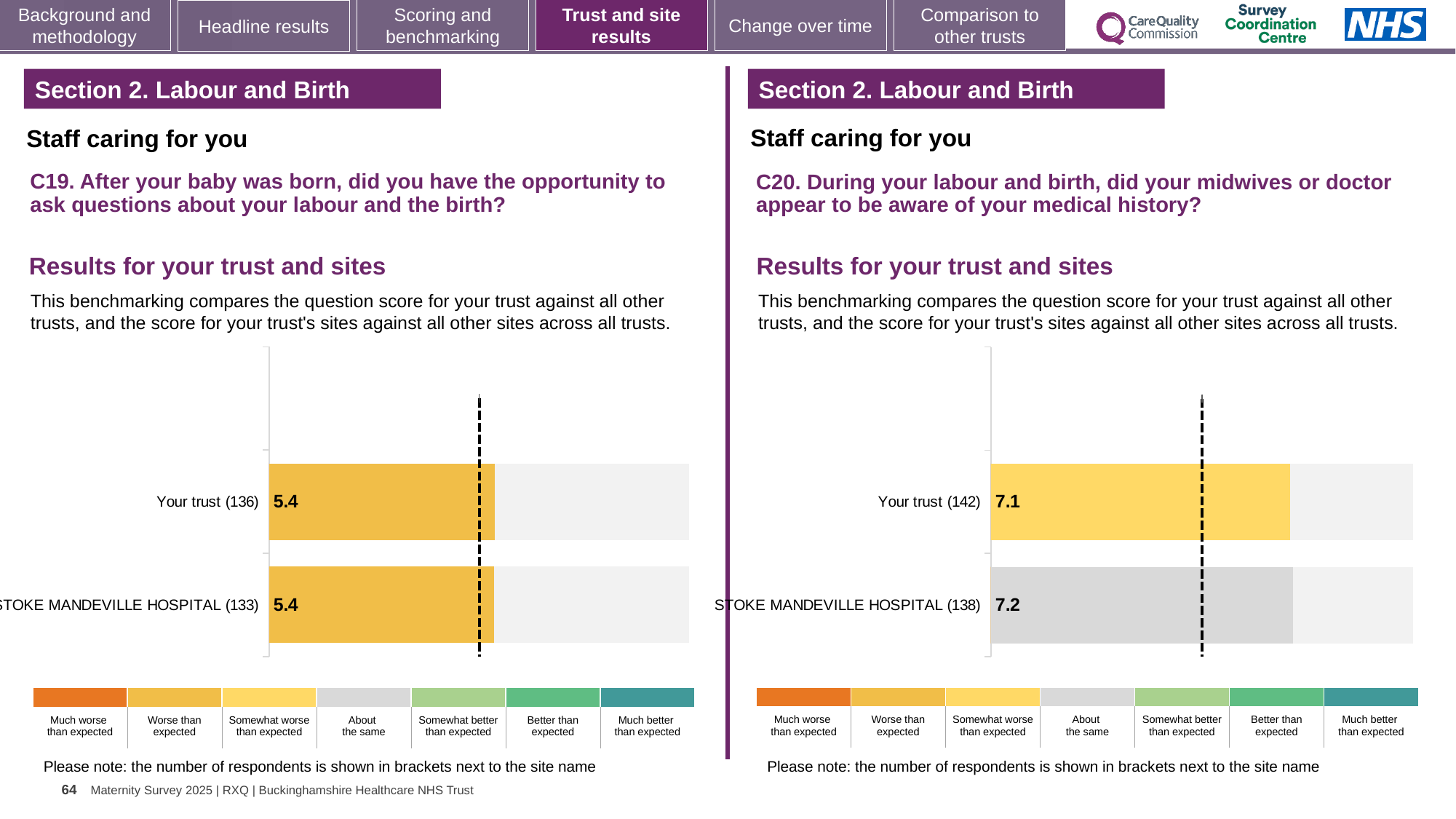
In the C20 chart on the right, what is the difference between the Stoke Mandeville Hospital score and the Your trust score? 0.1 In the C19 chart on the left, what is the score for Stoke Mandeville Hospital? 5.4 In the C19 chart on the left, what is the score for Your trust? 5.4 What type of chart is used for the C20 results on the right? Bar chart How many benchmark categories are shown in the colour key below the C20 chart on the right? 7 How many bars are plotted in the C19 chart on the left? 2 In the C20 chart on the right, what is the score for Stoke Mandeville Hospital? 7.2 In the C19 chart on the left, how many respondents are shown in brackets for Your trust? 136 How many bars are plotted in the C20 chart on the right? 2 In the C20 chart on the right, what is the score for Your trust? 7.1 In the C20 chart on the right, which has the higher score, Your trust or Stoke Mandeville Hospital? Stoke Mandeville Hospital In the C19 chart on the left, are the scores for Your trust and Stoke Mandeville Hospital equal? Yes